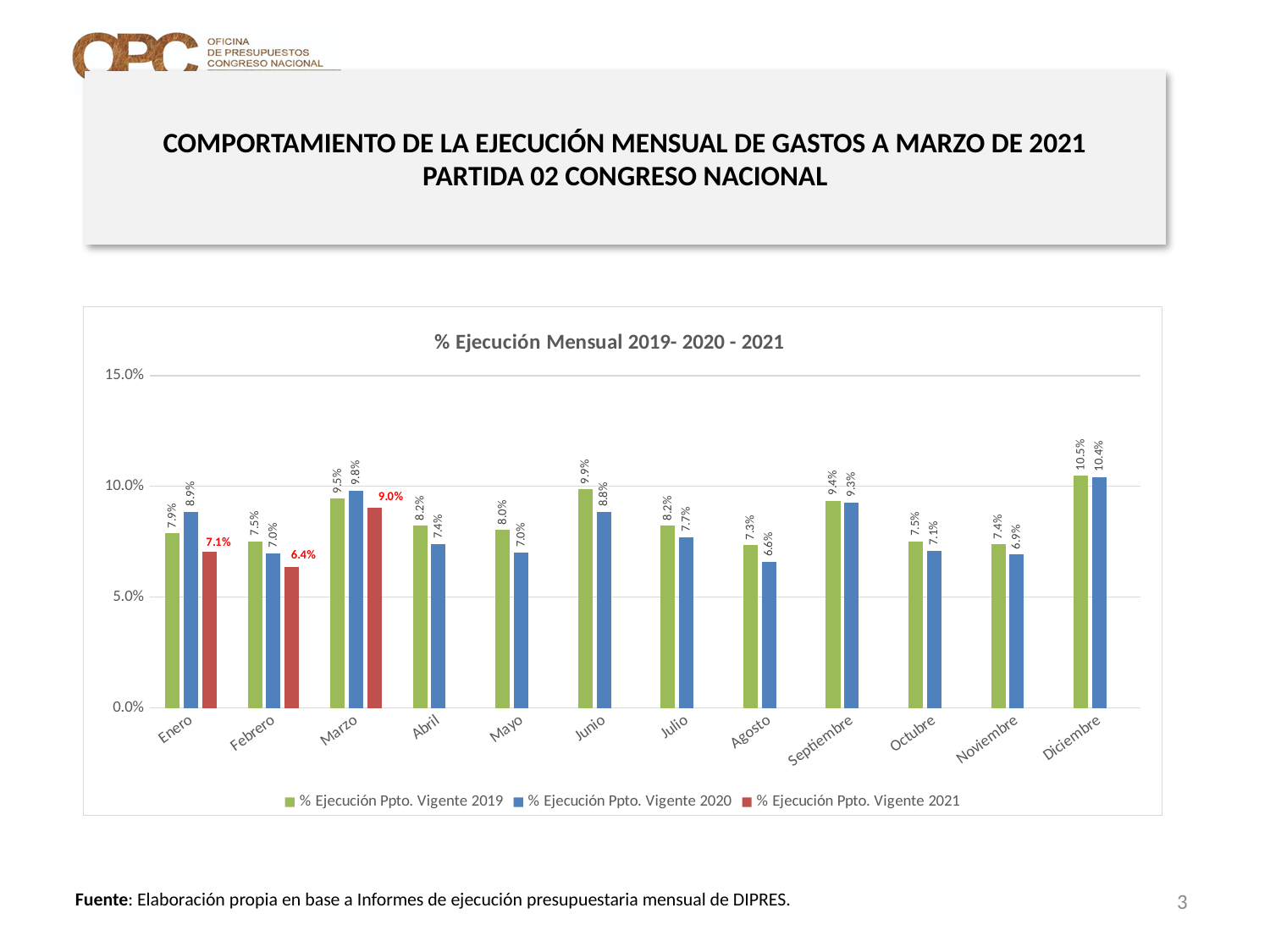
Which month has the highest value for % Ejecución Ppto. Vigente 2019? Diciembre What is the value for % Ejecución Ppto. Vigente 2020 in Agosto? 6.6% Which is larger in Febrero: the 2020 value or the 2021 value? 2020 value (7.0%) What type of chart is shown on the slide? bar chart Which month has the lowest value for % Ejecución Ppto. Vigente 2020? Agosto Is the value for % Ejecución Ppto. Vigente 2020 in Diciembre greater or less than 10.0%? greater How many months are shown on the x axis? 12 What is the difference between the 2019 and 2021 values in Enero? 0.8% How many series does the legend list? 3 What is the value for % Ejecución Ppto. Vigente 2019 in Junio? 9.9% What is the title of the chart? % Ejecución Mensual 2019- 2020 - 2021 What is the value for % Ejecución Ppto. Vigente 2021 in Marzo? 9.0%